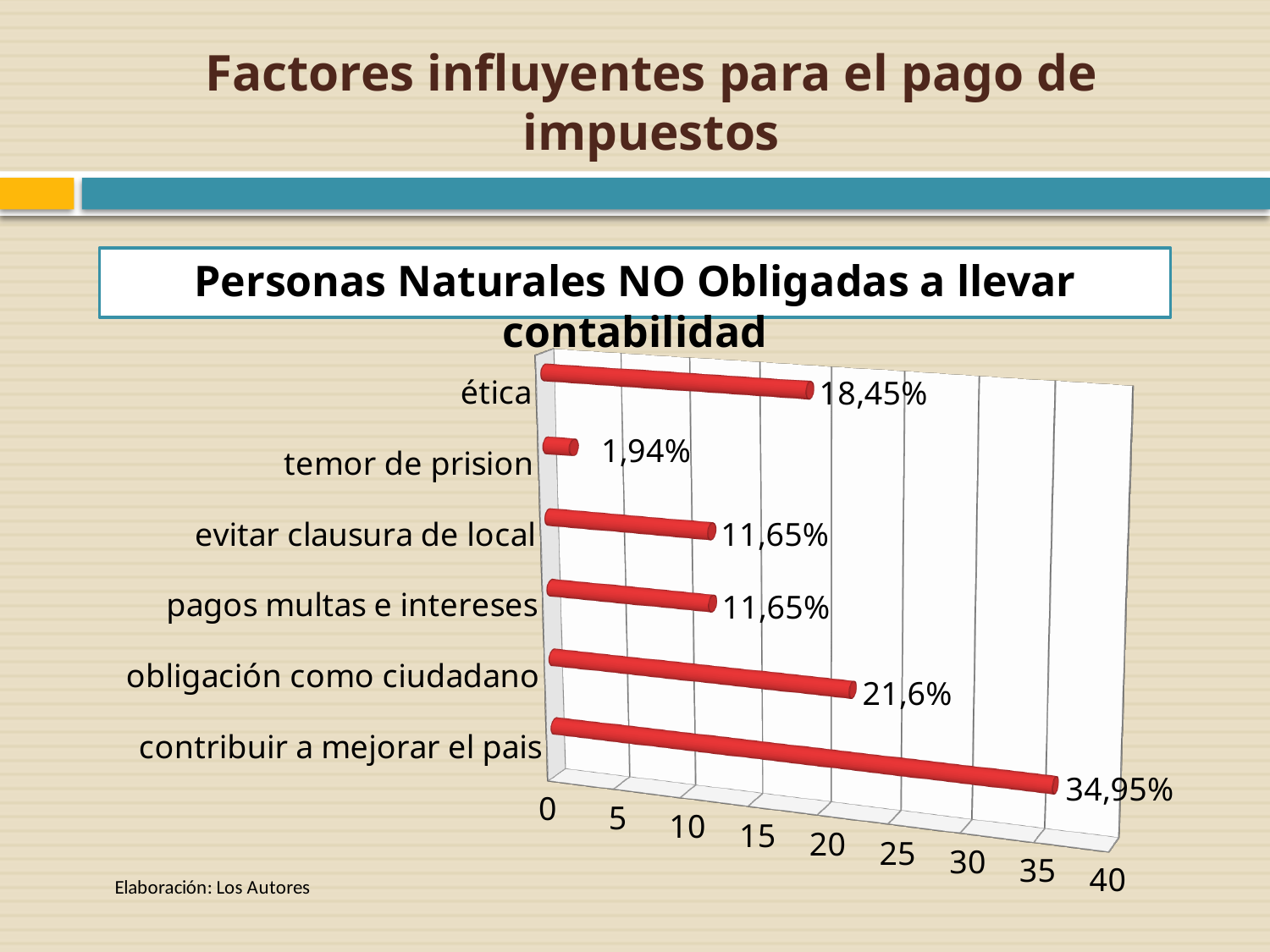
What is the difference between the values for "contribuir a mejorar el pais" and "obligación como ciudadano"? 13,35% What kind of chart is shown on the slide? bar chart How many categories are shown in the chart? 6 Which is larger, the value for "ética" or the value for "obligación como ciudadano"? obligación como ciudadano Which category has the lowest value? temor de prision Which category has the highest value? contribuir a mejorar el pais What is the value for "contribuir a mejorar el pais"? 34,95% What is the value for "temor de prision"? 1,94% What is the title of the chart? Personas Naturales NO Obligadas a llevar contabilidad What is the value for "obligación como ciudadano"? 21,6% What is the value for "ética"? 18,45% Is the value for "ética" greater or less than 20? less